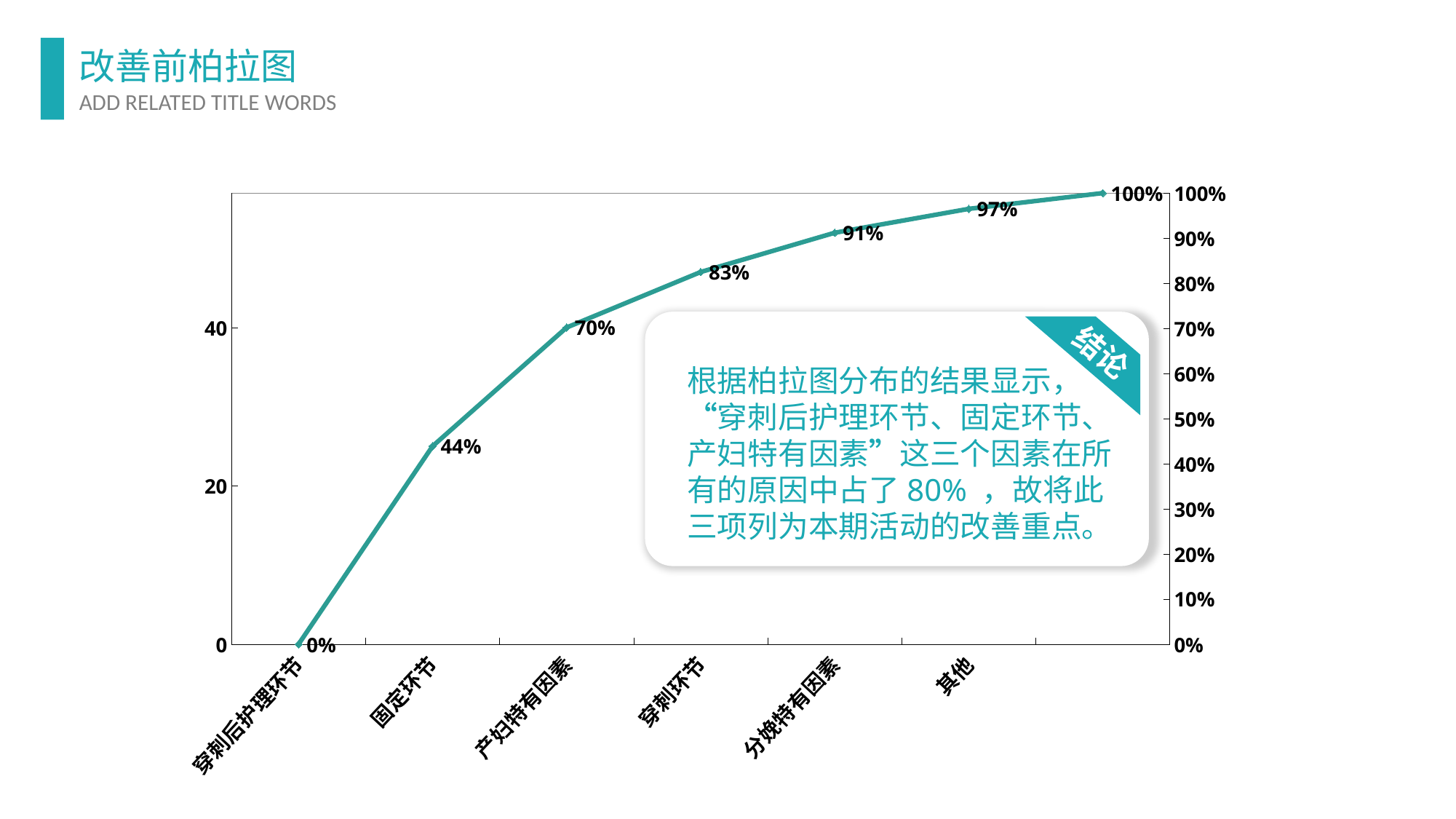
What is the cumulative percentage label at the point for 穿刺环节? 83% How many data labels are printed on the line? 7 Does the line rise or fall from left to right along the x axis? rise What is the title of the slide containing the chart? 改善前柏拉图 What is the cumulative percentage label at the point for 固定环节? 44% What is the difference between the cumulative percentage labels at 产妇特有因素 and 固定环节? 26% What is the cumulative percentage label at the point for 分娩特有因素? 91% What is the highest data label shown on the line? 100% What is the cumulative percentage label at the point for 其他? 97% What type of chart is shown on the slide? line chart What is the lowest data label shown on the line? 0% What is the cumulative percentage label at the point for 产妇特有因素? 70%